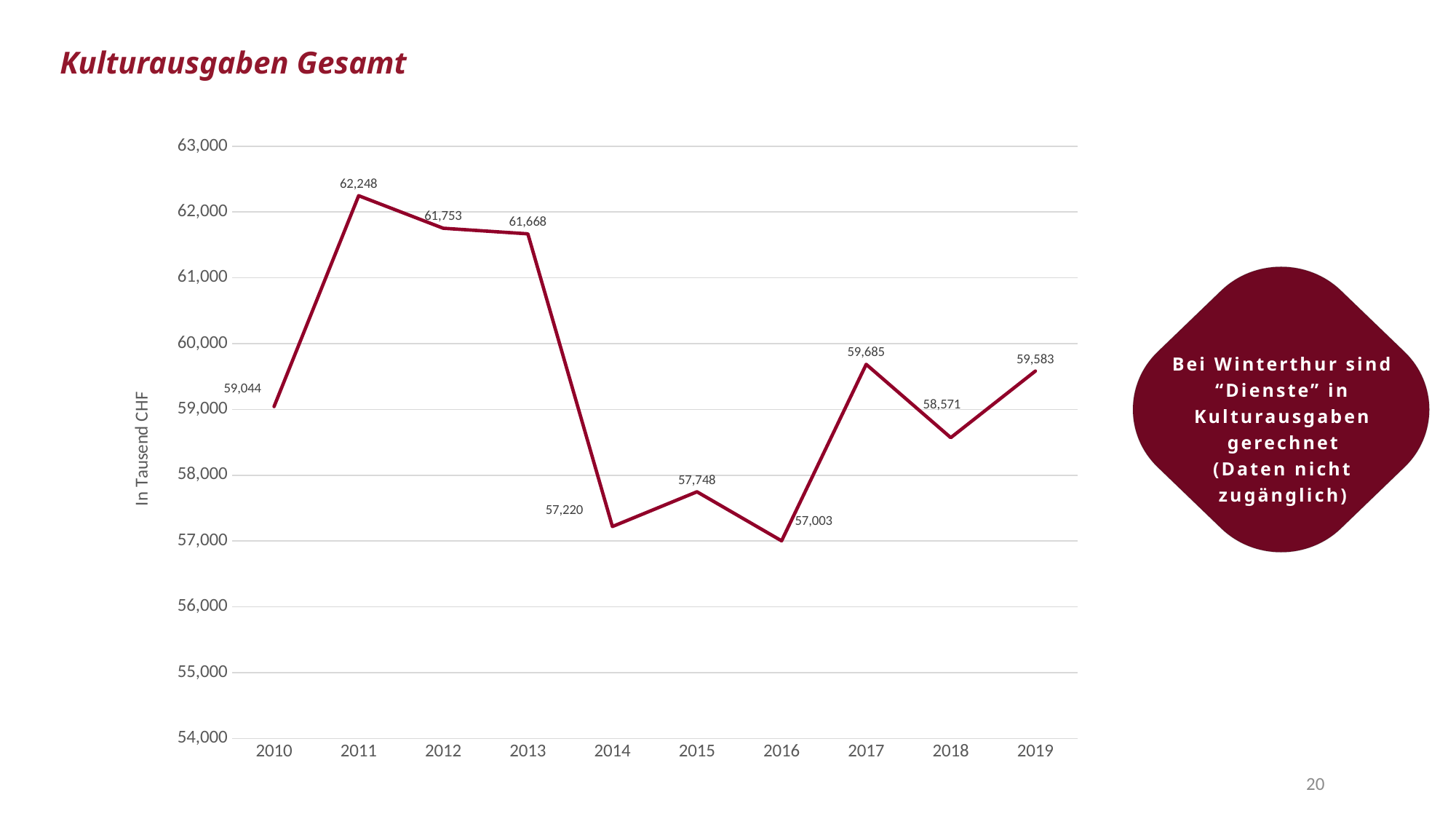
Is the value for 2014 greater or less than 58,000? less Which year has the highest value? 2011 What is the difference between the values for 2017 and 2018? 1,114 What is the difference between the values for 2011 and 2016? 5,245 How many years are plotted on the chart? 10 What is the title of the chart? Kulturausgaben Gesamt What kind of chart is shown on the slide? line chart What is the value for 2019? 59,583 What is the value for 2011? 62,248 What is the value for 2016? 57,003 Which is larger, the value for 2010 or the value for 2019? 2019 Which year has the lowest value? 2016